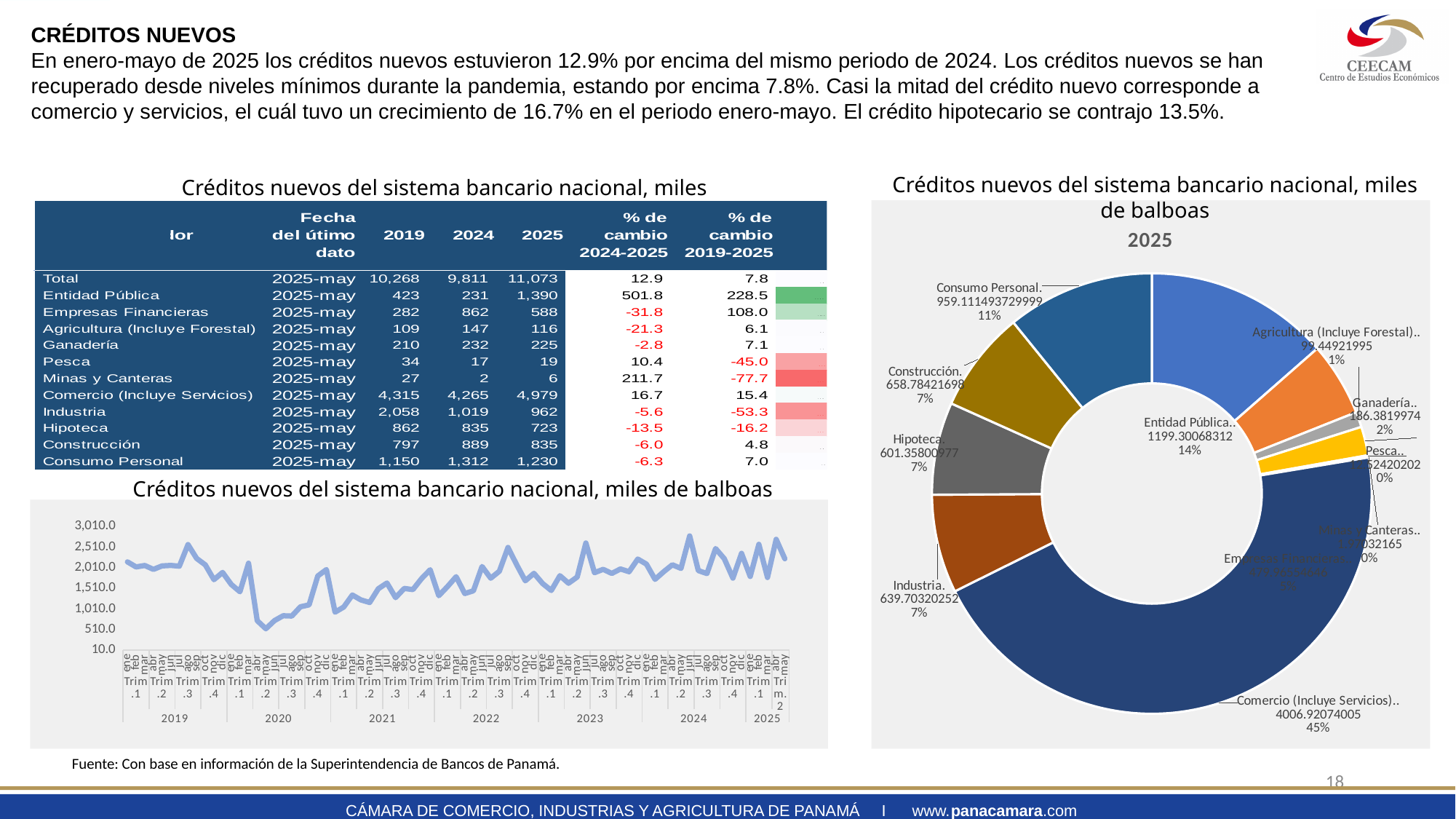
In the doughnut chart on the right, what is the value shown for Comercio (Incluye Servicios)? 4006.92074005 In the doughnut chart on the right, what share does Consumo Personal have? 11% In the line chart at the bottom left, is the value for the first point (ene 2019) greater or less than 1,510.0? greater In the doughnut chart on the right, what share does Comercio (Incluye Servicios) have? 45% What kind of chart is the chart titled 'Créditos nuevos del sistema bancario nacional, miles de balboas' at the bottom left of the slide? Line chart What year is shown as the subtitle of the doughnut chart on the right? 2025 What kind of chart is the chart titled 'Créditos nuevos del sistema bancario nacional, miles de balboas' on the right side of the slide? Doughnut chart In the doughnut chart on the right, which is larger, Construcción or Agricultura (Incluye Forestal)? Construcción In the doughnut chart on the right, which category has the largest slice? Comercio (Incluye Servicios) In the doughnut chart on the right, what share does Ganadería have? 2% In the doughnut chart on the right, what is the value shown for Entidad Pública? 1199.30068312